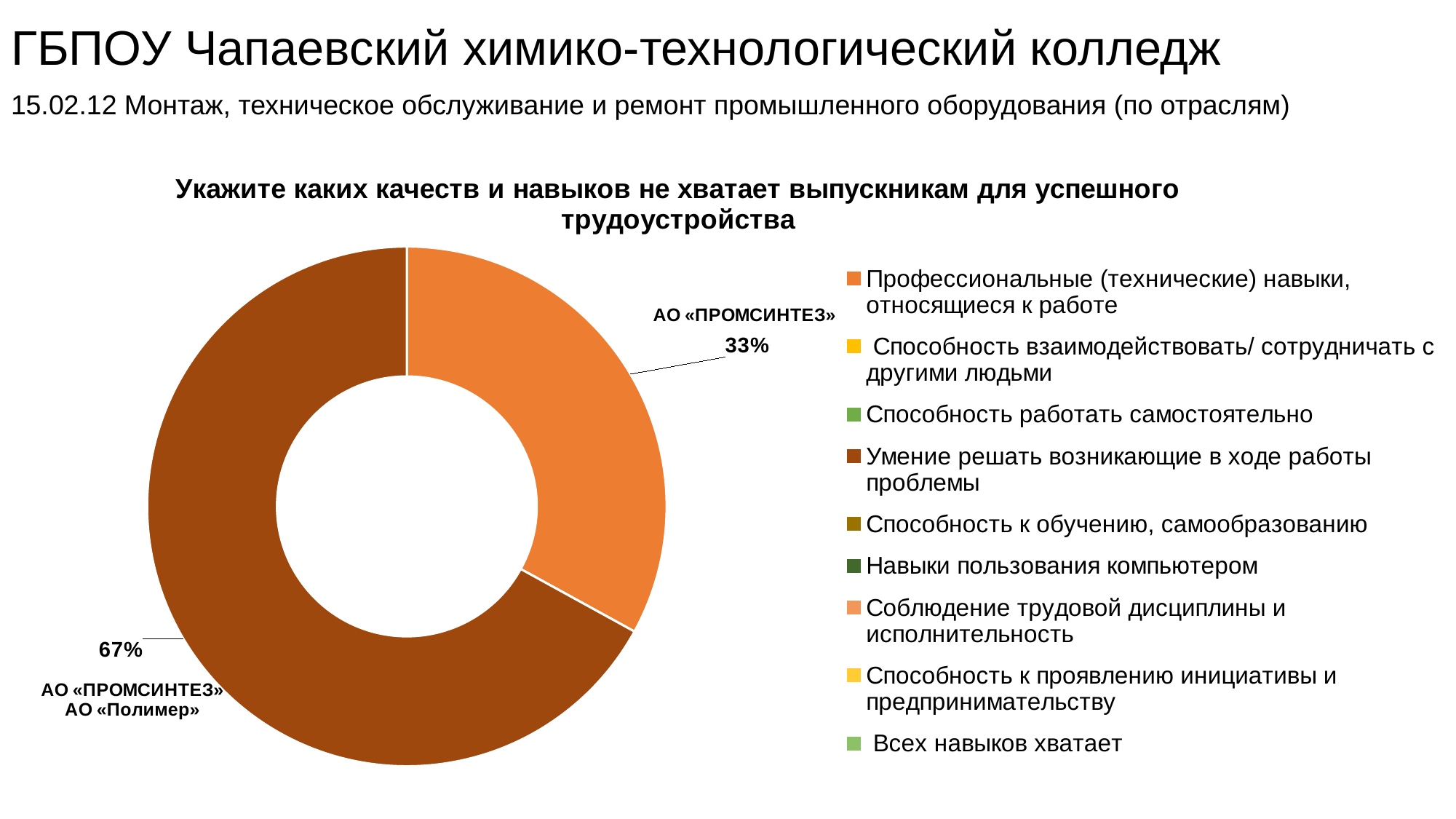
How many slices with data labels are visible in the chart? 2 Which employers are named in the data label next to the 67% slice? АО «ПРОМСИНТЕЗ» and АО «Полимер» What share of the chart does the slice for «Умение решать возникающие в ходе работы проблемы» take? 67% What kind of chart is shown on the slide? Doughnut (pie) chart What is the title of the chart? Укажите каких качеств и навыков не хватает выпускникам для успешного трудоустройства Which employer is named in the data label next to the 33% slice? АО «ПРОМСИНТЕЗ» Which of the two visible slices is smaller? Профессиональные (технические) навыки, относящиеся к работе What is the difference in percentage points between the 67% slice and the 33% slice? 34 percentage points Which category has the largest slice in the chart? Умение решать возникающие в ходе работы проблемы Is the slice for «Умение решать возникающие в ходе работы проблемы» larger or smaller than the slice for «Профессиональные (технические) навыки, относящиеся к работе»? Larger What share of the chart does the slice for «Профессиональные (технические) навыки, относящиеся к работе» take? 33% How many entries does the chart legend list? 9